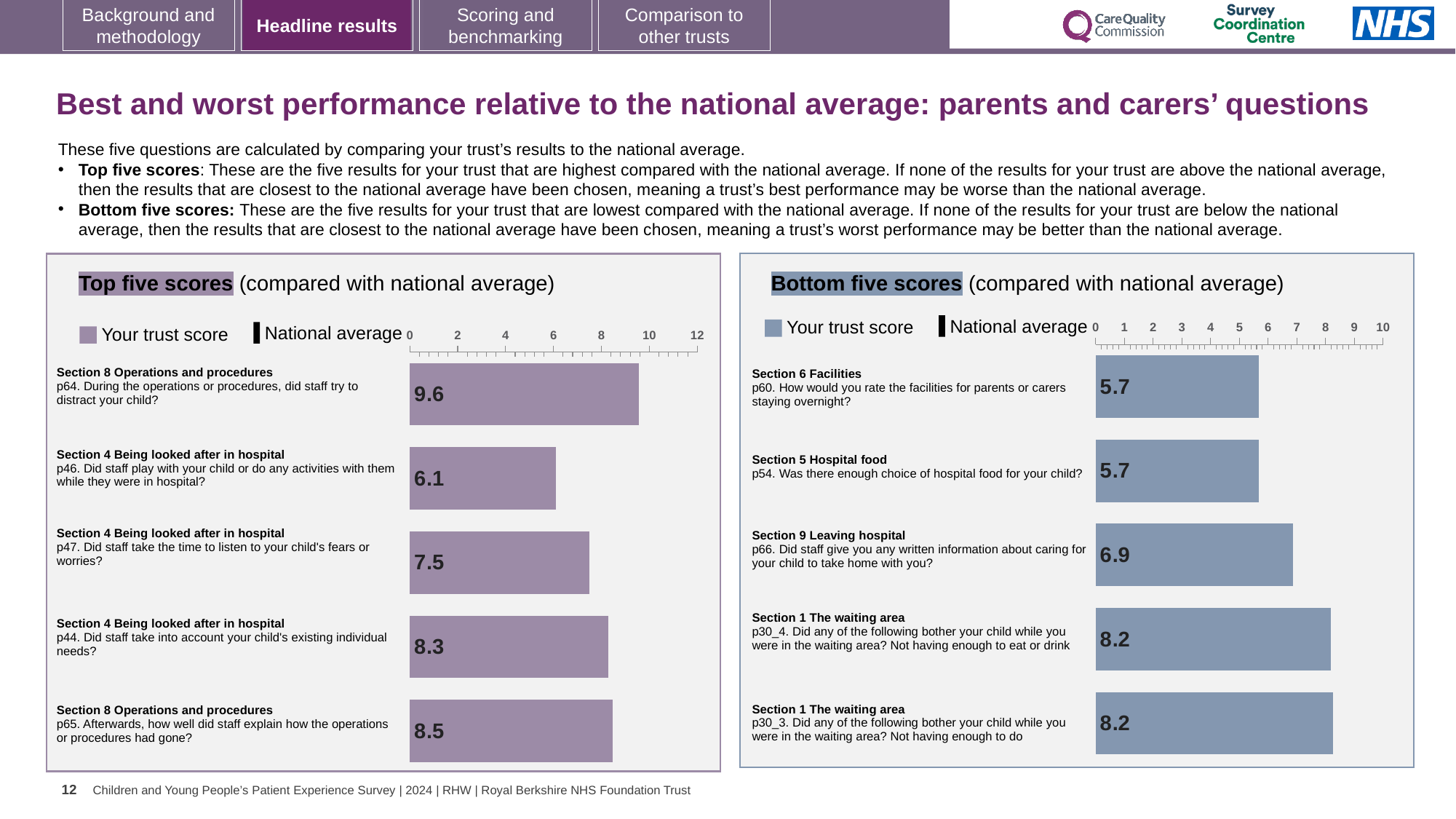
In the Top five scores chart, what is the trust score for p46 (did staff play with your child or do any activities with them)? 6.1 In the Bottom five scores chart, what is the difference between the trust scores for p30_4 and p66? 1.3 How many entries does the legend of the Bottom five scores chart list? 2 In the Top five scores chart, which has the larger trust score: p44 or p65? p65 In the Top five scores chart, what is the trust score for p64 (did staff try to distract your child during operations or procedures)? 9.6 In the Top five scores chart, which question has the highest trust score? p64. During the operations or procedures, did staff try to distract your child? In the Bottom five scores chart, what is the trust score for p60 (rating of facilities for parents or carers staying overnight)? 5.7 How many questions are plotted in the Bottom five scores chart? 5 In the Bottom five scores chart, what is the trust score for p66 (written information about caring for your child at home)? 6.9 What kind of chart is the Top five scores chart? Bar chart In the Top five scores chart, which question has the lowest trust score? p46. Did staff play with your child or do any activities with them while they were in hospital? In the Top five scores chart, what is the difference between the trust scores for p64 and p46? 3.5